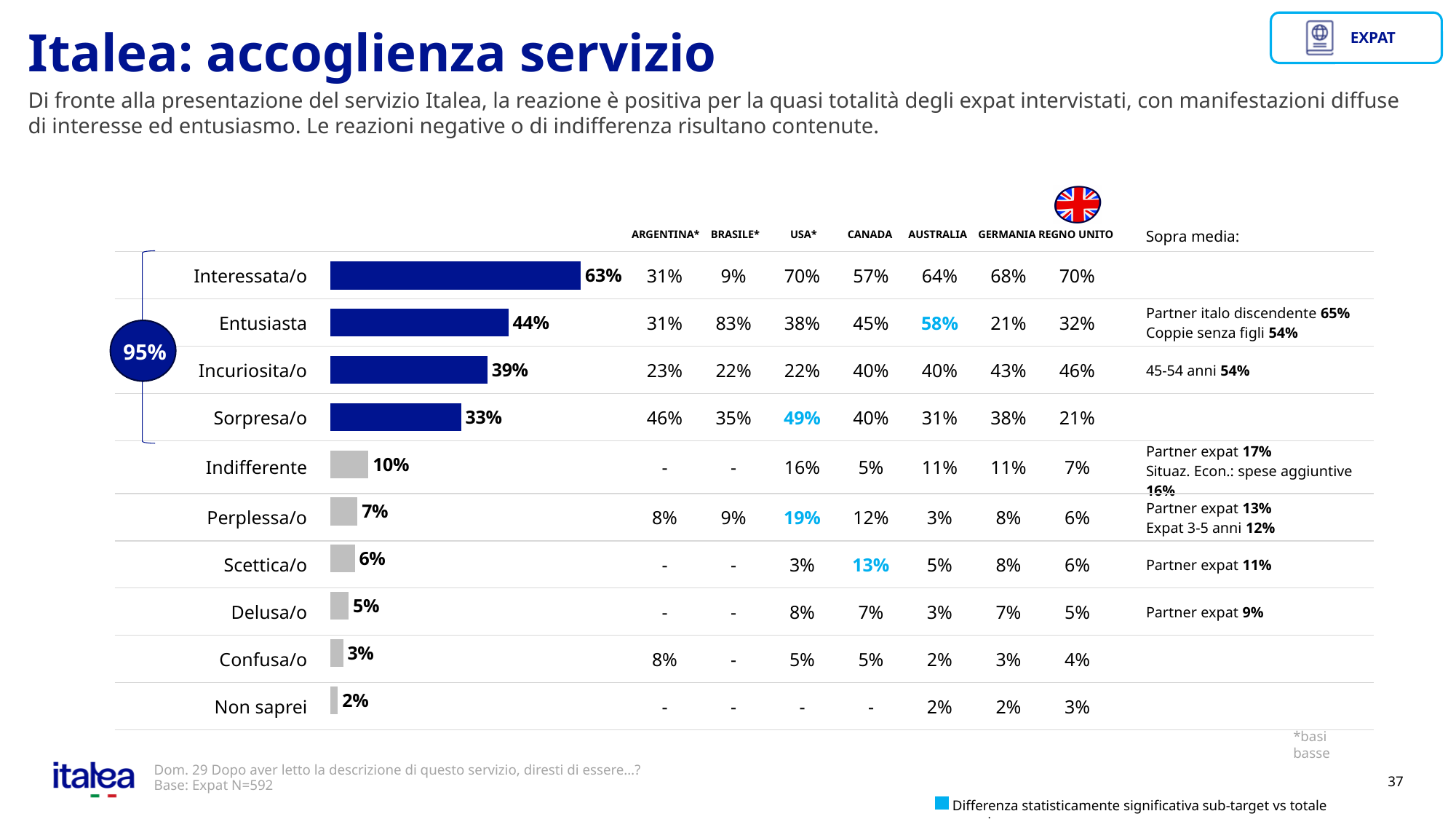
What colour are the bars for the negative or indifferent reactions (Indifferente through Non saprei)? Grey What is the difference between the values for Incuriosita/o and Sorpresa/o? 6% What is the value shown for Indifferente in the bar chart? 10% What kind of chart is shown on the slide? Bar chart How many categories are shown in the bar chart? 10 What is the difference between the values for Interessata/o and Entusiasta? 19% What percentage is shown in the circle grouping the first four categories? 95% Which category has the highest value in the bar chart? Interessata/o Which category has the lowest value in the bar chart? Non saprei What is the value shown for Sorpresa/o in the bar chart? 33% What is the value shown for Interessata/o in the bar chart? 63% Which is larger, the value for Perplessa/o or the value for Scettica/o? Perplessa/o